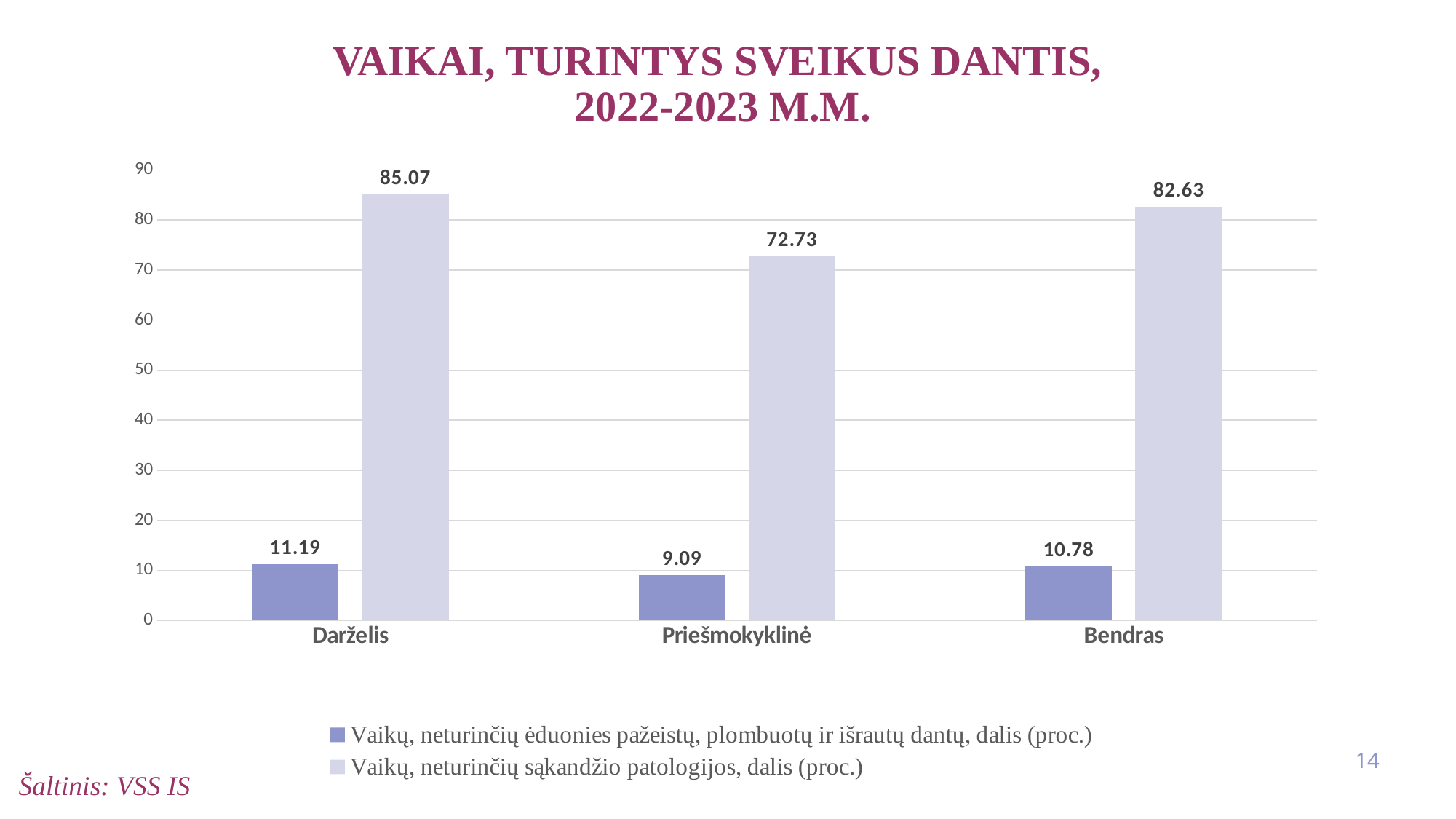
What kind of chart is shown on the slide? bar chart What is the difference between the two series values for Darželis? 73.88 Is the 'Vaikų, neturinčių sąkandžio patologijos' value for Priešmokyklinė greater or less than 80? less What is the value for Darželis in the series 'Vaikų, neturinčių ėduonies pažeistų, plombuotų ir išrautų dantų, dalis (proc.)'? 11.19 What is the value for Priešmokyklinė in the series 'Vaikų, neturinčių sąkandžio patologijos, dalis (proc.)'? 72.73 Which is larger: the 'Vaikų, neturinčių ėduonies pažeistų, plombuotų ir išrautų dantų' value for Darželis or for Bendras? Darželis Which category has the lowest value in the series 'Vaikų, neturinčių ėduonies pažeistų, plombuotų ir išrautų dantų, dalis (proc.)'? Priešmokyklinė How many series does the legend list? 2 How many categories are shown on the x axis? 3 Which category has the highest value in the series 'Vaikų, neturinčių sąkandžio patologijos, dalis (proc.)'? Darželis What is the difference between the 'Vaikų, neturinčių sąkandžio patologijos' values for Darželis and Priešmokyklinė? 12.34 What is the value for Bendras in the series 'Vaikų, neturinčių sąkandžio patologijos, dalis (proc.)'? 82.63